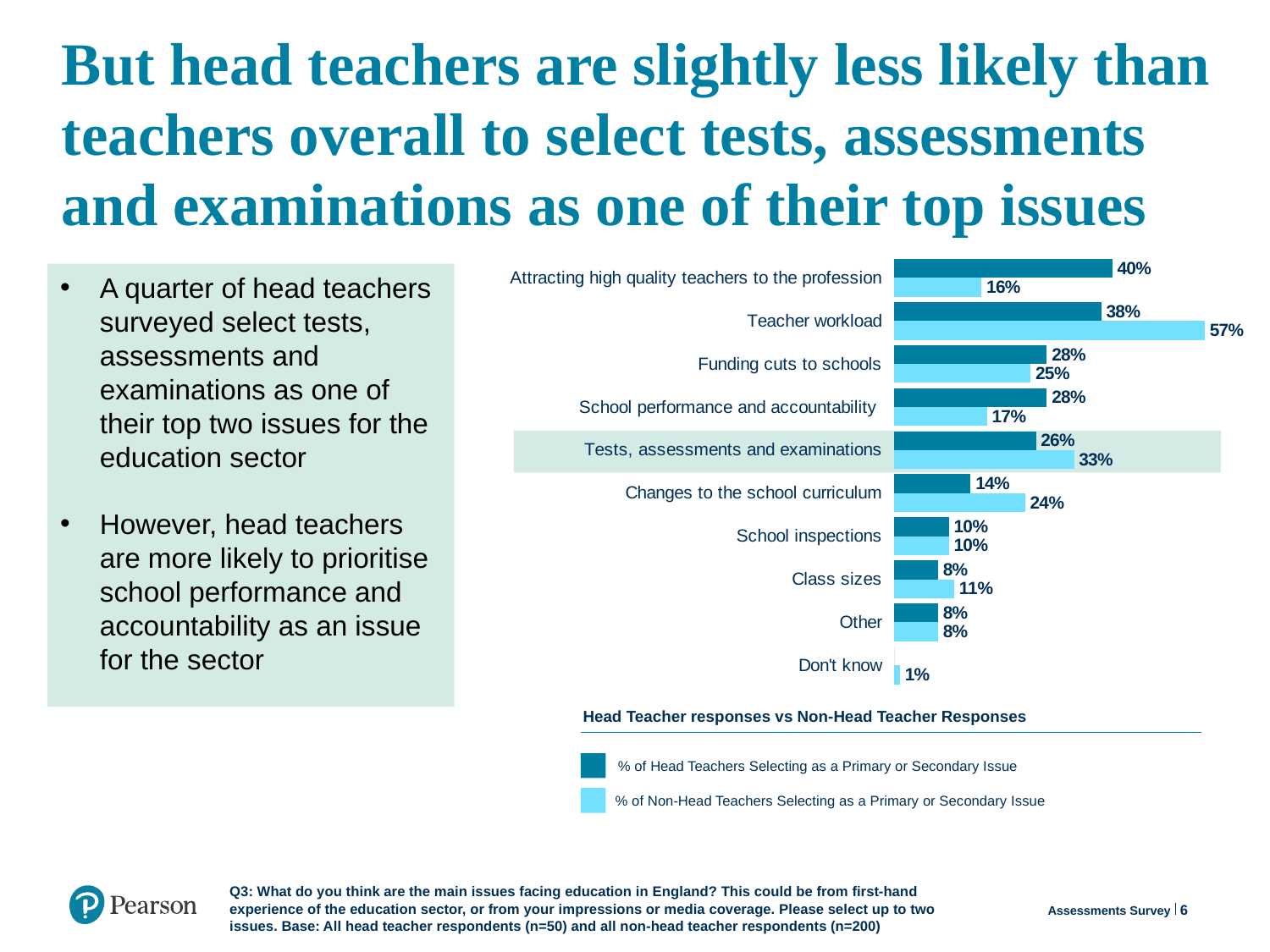
How many series does the legend list? 2 Which issue has the highest percentage among non-head teachers? Teacher workload What is the difference between the non-head teacher and head teacher percentages for Teacher workload? 19% Which issue has the highest percentage among head teachers? Attracting high quality teachers to the profession What percentage of non-head teachers selected Tests, assessments and examinations as a primary or secondary issue? 33% For Changes to the school curriculum, which group has the larger percentage, head teachers or non-head teachers? Non-head teachers What type of chart is shown on the slide? Bar chart What is the difference between the head teacher and non-head teacher percentages for Attracting high quality teachers to the profession? 24% What percentage of head teachers selected School performance and accountability? 28% How many issue categories are shown on the chart? 10 What is the title of the chart? Head Teacher responses vs Non-Head Teacher Responses What percentage of head teachers selected Teacher workload as a primary or secondary issue? 38%